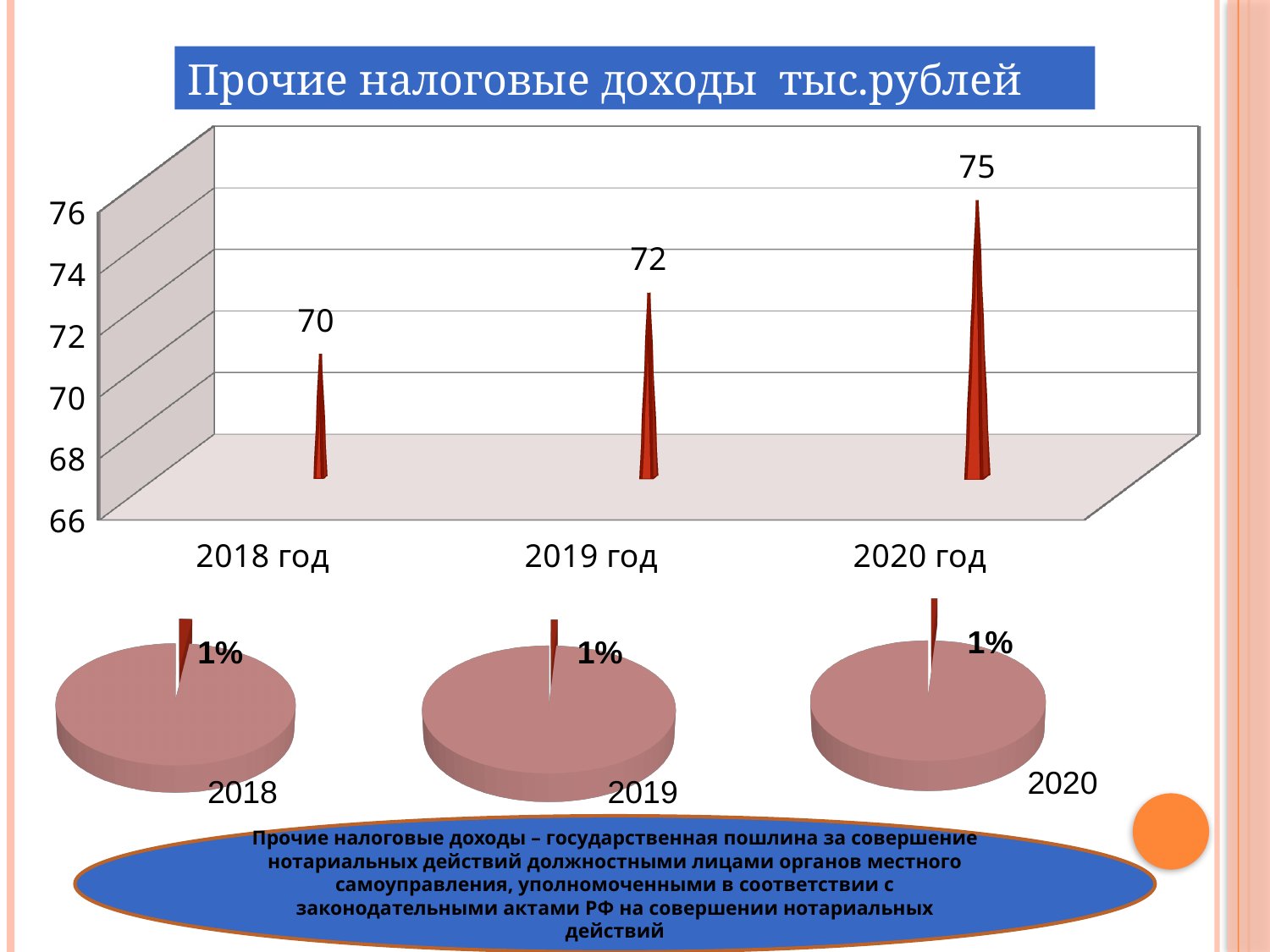
In the bar chart 'Прочие налоговые доходы тыс.рублей', which is larger, the value for 2019 год or 2018 год? 2019 год In the bar chart 'Прочие налоговые доходы тыс.рублей', do the values rise or fall from 2018 год to 2020 год? rise How many years are shown in the bar chart 'Прочие налоговые доходы тыс.рублей'? 3 In the pie chart labelled 2019 at the bottom of the slide, what share does the highlighted slice have? 1% In the bar chart 'Прочие налоговые доходы тыс.рублей', what is the value for 2019 год? 72 In the bar chart 'Прочие налоговые доходы тыс.рублей', which year has the highest value? 2020 год In the bar chart 'Прочие налоговые доходы тыс.рублей', what is the value for 2018 год? 70 In the bar chart 'Прочие налоговые доходы тыс.рублей', what is the difference between the values for 2020 год and 2018 год? 5 What kind of chart is the top chart titled 'Прочие налоговые доходы тыс.рублей'? bar chart In the bar chart 'Прочие налоговые доходы тыс.рублей', which year has the lowest value? 2018 год In the bar chart 'Прочие налоговые доходы тыс.рублей', is the value for 2020 год greater or less than 74? greater In the bar chart 'Прочие налоговые доходы тыс.рублей', what is the value for 2020 год? 75